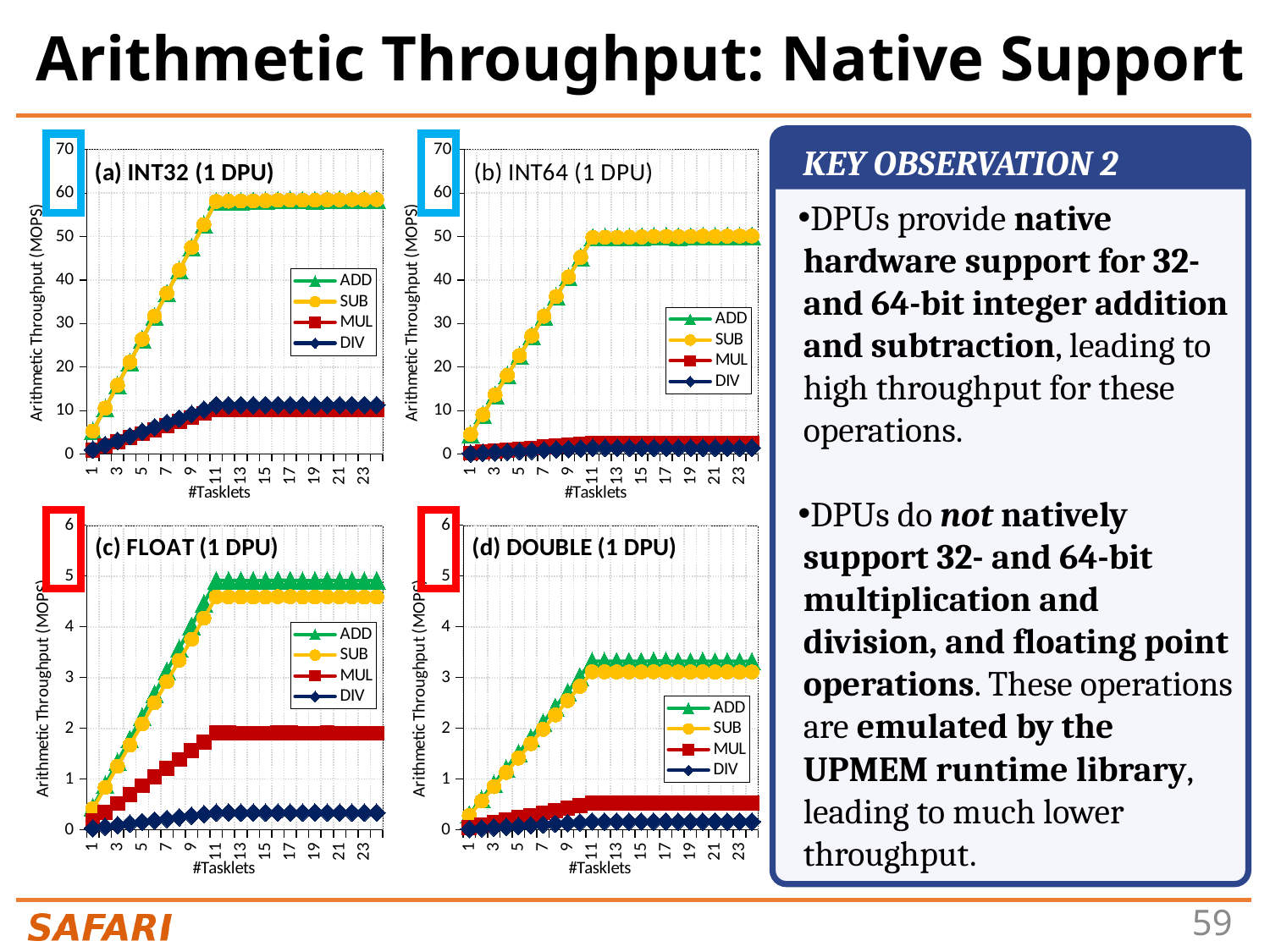
In chart (b) INT64 (1 DPU), is the value for MUL at 23 tasklets greater or less than 10? less In chart (d) DOUBLE (1 DPU), is the value for DIV at 23 tasklets greater or less than 1? less How many series does the legend of chart (a) INT32 (1 DPU) list? 4 What kind of chart is chart (a) INT32 (1 DPU)? line chart In chart (c) FLOAT (1 DPU), is the value for MUL at 23 tasklets greater or less than 1? greater In chart (a) INT32 (1 DPU), does the ADD series rise or fall as the number of tasklets increases from 1 to 11? rise In chart (d) DOUBLE (1 DPU), which series has the lowest value at 23 tasklets? DIV What are the legend entries in chart (c) FLOAT (1 DPU)? ADD, SUB, MUL, DIV In chart (c) FLOAT (1 DPU), which is larger at 23 tasklets, MUL or DIV? MUL